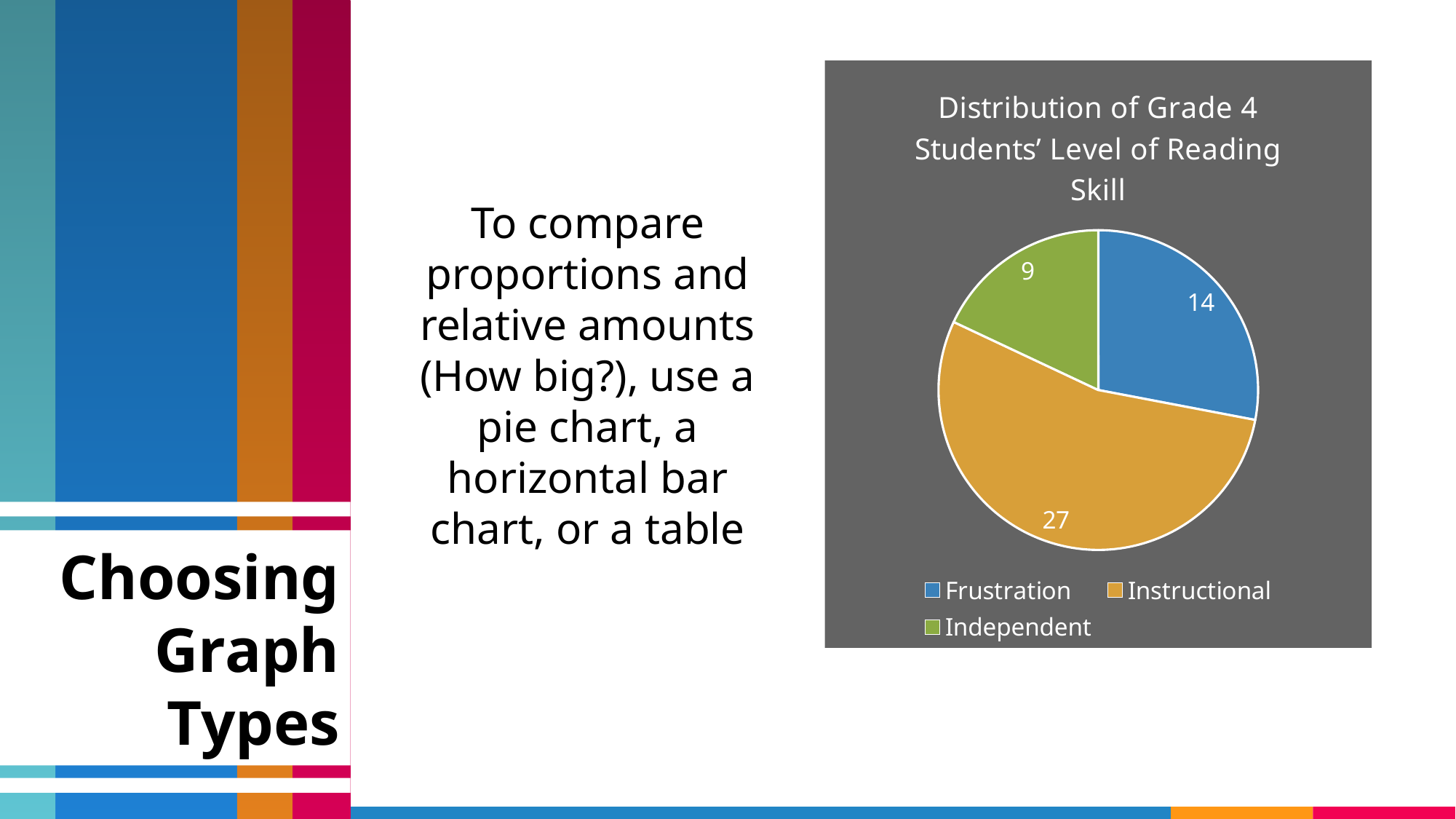
Which category has the smallest slice? Independent Which is larger, Frustration or Independent? Frustration What share of the pie does Instructional represent? 54% What is the value for Instructional? 27 What is the total of all slices in the pie chart? 50 How many slices does the pie chart have? 3 What is the value for Independent? 9 What is the difference between the Instructional and Frustration values? 13 Which category has the largest slice? Instructional What kind of chart is shown on the slide? pie chart What is the value for Frustration? 14 What is the title of the chart? Distribution of Grade 4 Students' Level of Reading Skill